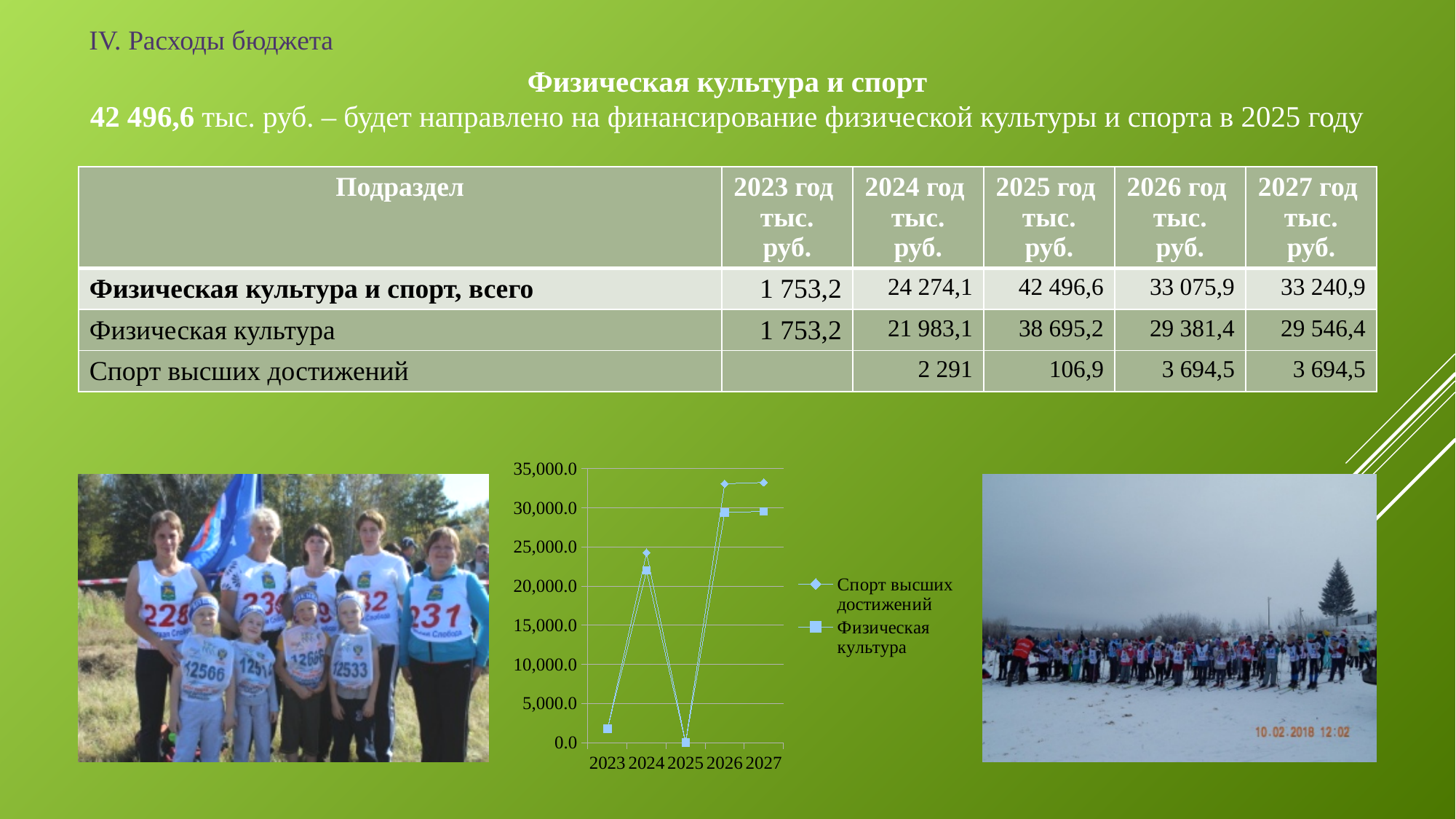
Is the value for Физическая культура in 2023 greater or less than 5,000? less What kind of chart is shown on the slide? line chart Is the value for Физическая культура in 2027 greater or less than 25,000? greater Is the value for Физическая культура in 2024 greater or less than 20,000? greater How many years are shown on the x axis of the chart? 5 In which year is the value for Физическая культура lowest? 2025 Does the value for Физическая культура rise or fall from 2025 to 2026? rise What is the highest value shown on the chart's y axis? 35,000.0 How many series does the chart legend list? 2 What are the two series named in the chart legend? Спорт высших достижений and Физическая культура